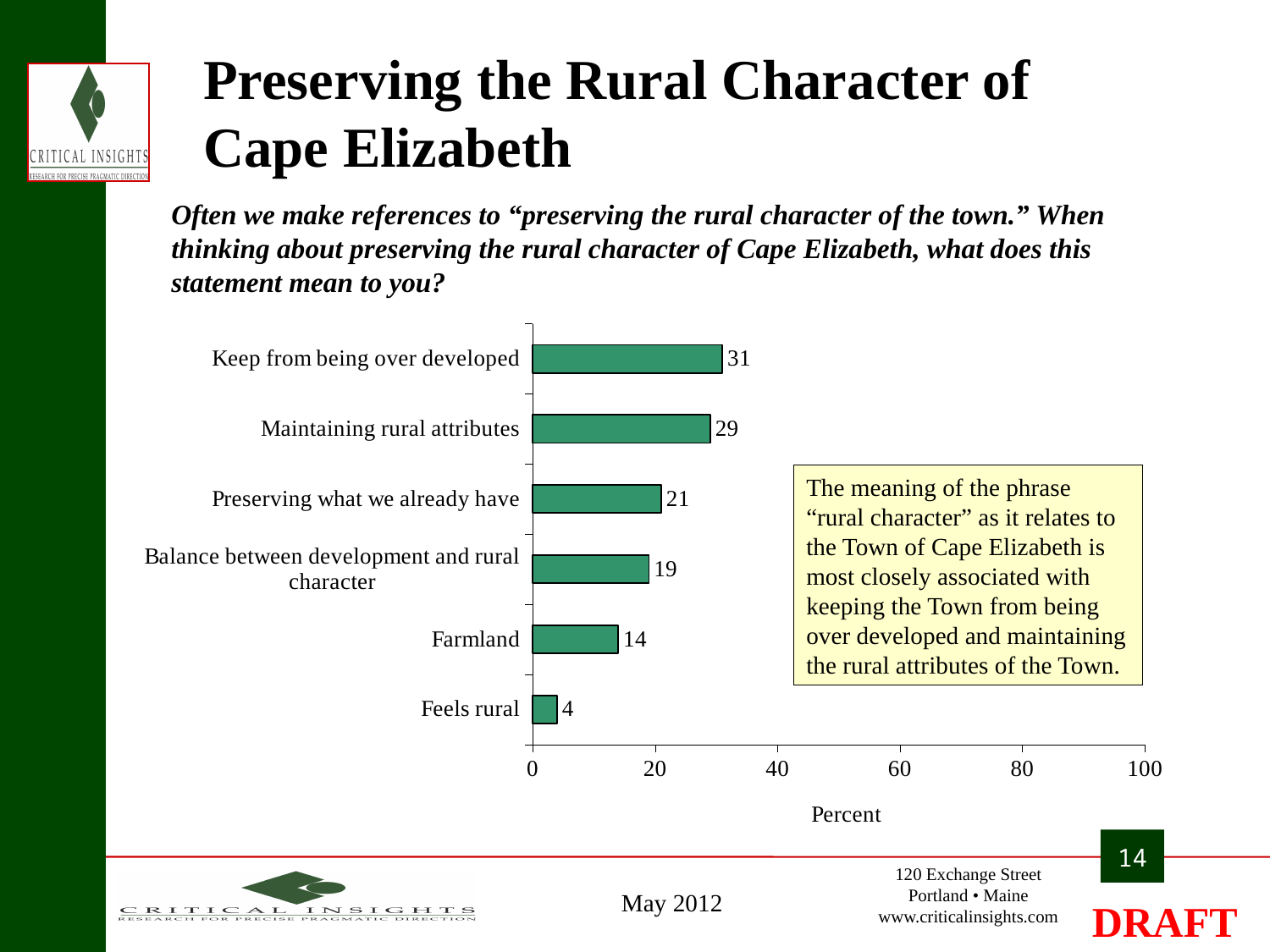
What is the value for "Farmland"? 14 What kind of chart is shown on the slide? Bar chart What is the value for "Keep from being over developed"? 31 What is the difference between the values for "Maintaining rural attributes" and "Preserving what we already have"? 8 What is the value for "Balance between development and rural character"? 19 Which category has the highest value? Keep from being over developed Which is larger, the value for "Farmland" or the value for "Feels rural"? Farmland Which category has the lowest value? Feels rural Is the value for "Preserving what we already have" greater or less than 40? less What is the label on the horizontal axis of the chart? Percent What is the maximum value shown on the horizontal axis? 100 How many categories are shown in the chart? 6